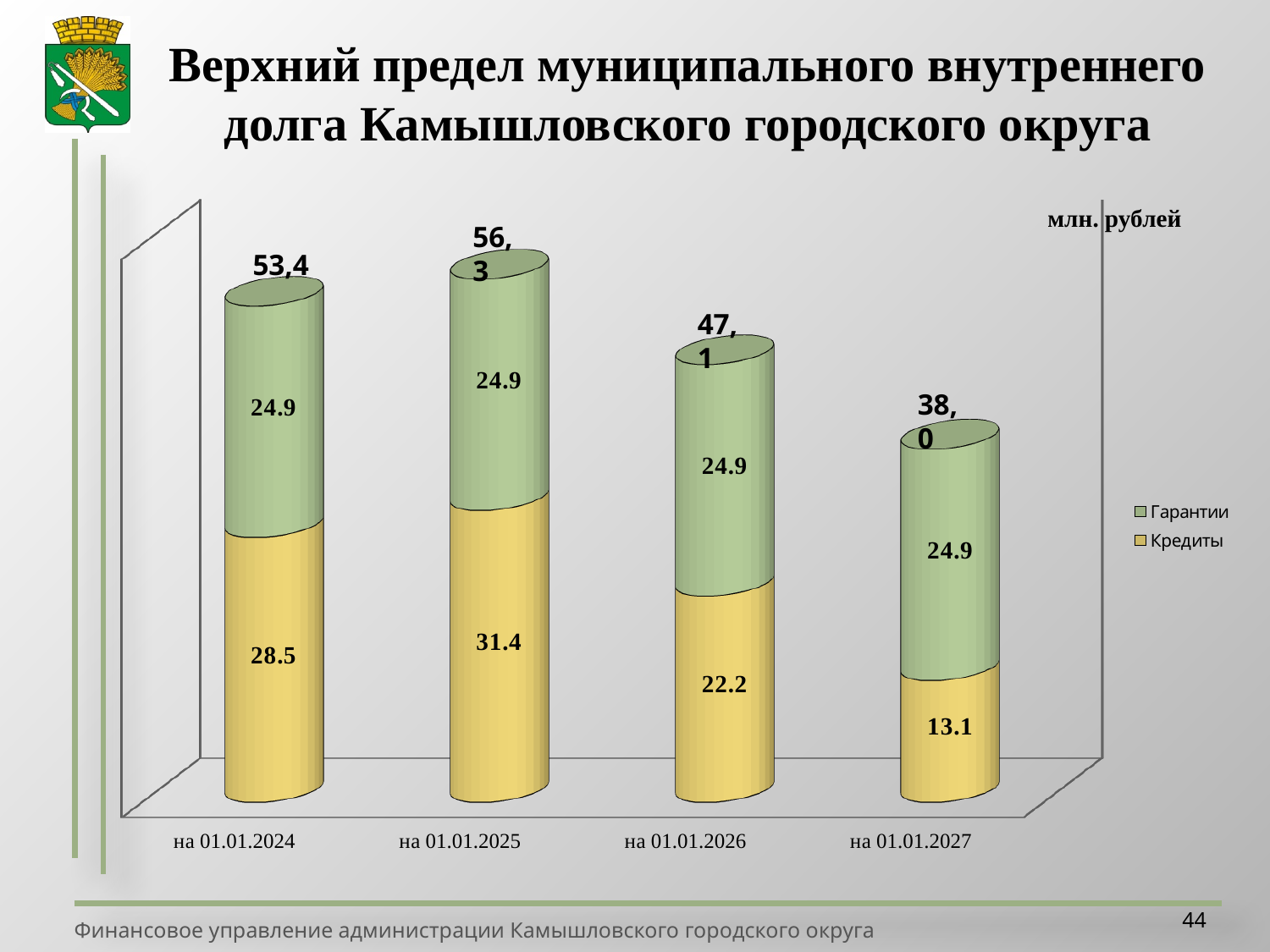
What is the value of Гарантии for на 01.01.2026? 24.9 What is the total shown above the bar for на 01.01.2027? 38,0 What is the total shown above the bar for на 01.01.2025? 56,3 Which date has the highest value of Кредиты? на 01.01.2025 What is the difference between the Кредиты values for на 01.01.2025 and на 01.01.2026? 9.2 Which is larger: Кредиты for на 01.01.2024 or Кредиты for на 01.01.2026? на 01.01.2024 What is the value of Кредиты for на 01.01.2027? 13.1 How many dates (categories) are shown on the x axis? 4 How many series does the legend list? 2 What kind of chart is shown on the slide? Stacked bar chart Which date has the lowest total debt? на 01.01.2027 What is the value of Кредиты for на 01.01.2024? 28.5